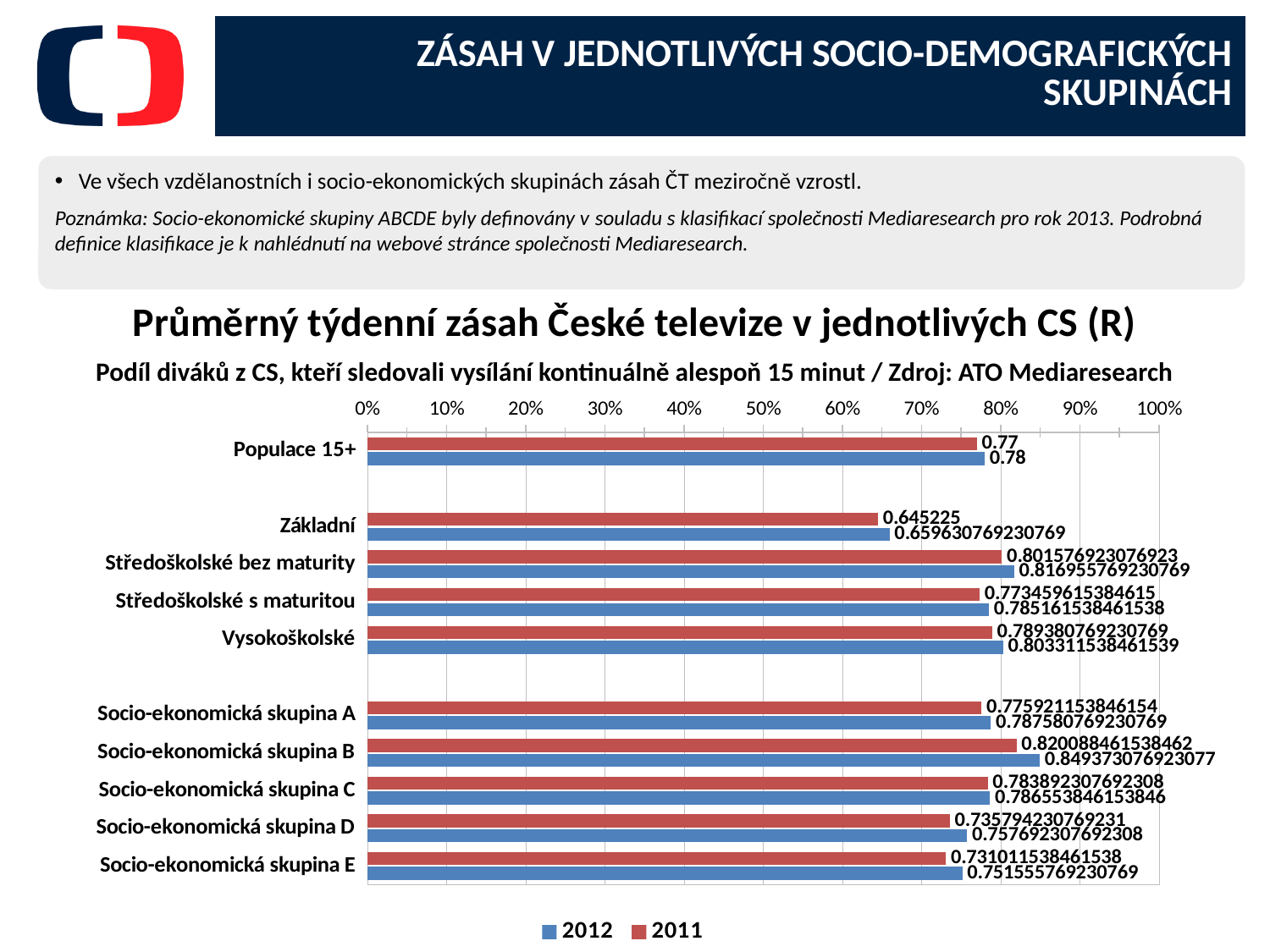
What is the 2011 value for Vysokoškolské? 0.789380769230769 How many categories are shown on the chart? 10 What is the 2012 value for Populace 15+? 0.78 What is the 2012 value for Socio-ekonomická skupina B? 0.849373076923077 Which category has the lowest 2011 value? Základní Is the 2012 value for Základní greater or less than 70%? less How many series does the legend list? 2 What is the difference between the 2012 and 2011 values for Populace 15+? 0.01 Which category has the highest 2012 value? Socio-ekonomická skupina B Which is larger: the 2012 value for Základní or the 2012 value for Vysokoškolské? Vysokoškolské What is the 2011 value for Základní? 0.645225 What kind of chart is shown on the slide? bar chart